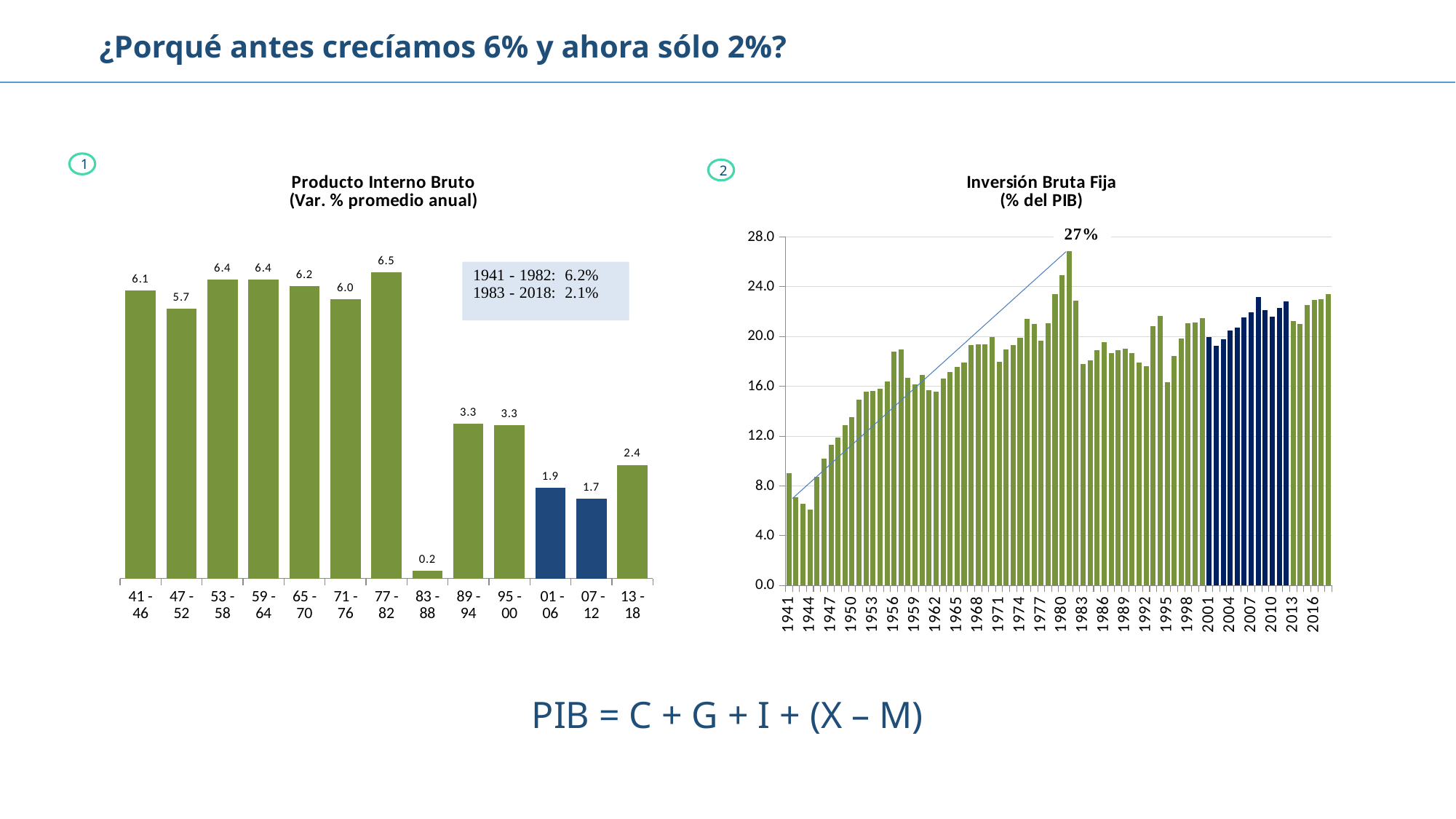
In the 'Producto Interno Bruto' chart, which period has the lowest value? 83 - 88 What is the subtitle shown under 'Inversión Bruta Fija' in the right-hand chart's title? (% del PIB) In the 'Producto Interno Bruto' chart, what is the value for 83 - 88? 0.2 In the 'Producto Interno Bruto' chart, which is larger, the value for 01 - 06 or the value for 07 - 12? 01 - 06 How many periods are shown in the 'Producto Interno Bruto' chart? 13 In the 'Producto Interno Bruto' chart, which period has the highest value? 77 - 82 In the 'Inversión Bruta Fija' chart, is the value for 2016 greater or less than 20.0? greater What kind of chart is the 'Producto Interno Bruto' chart? bar chart In the 'Producto Interno Bruto' chart, what is the difference between the values for 41 - 46 and 47 - 52? 0.4 In the 'Producto Interno Bruto' chart, what is the value for 77 - 82? 6.5 In the 'Inversión Bruta Fija' chart, is the value for 1941 greater or less than 12.0? less In the 'Inversión Bruta Fija' chart, what is the labelled peak value? 27%